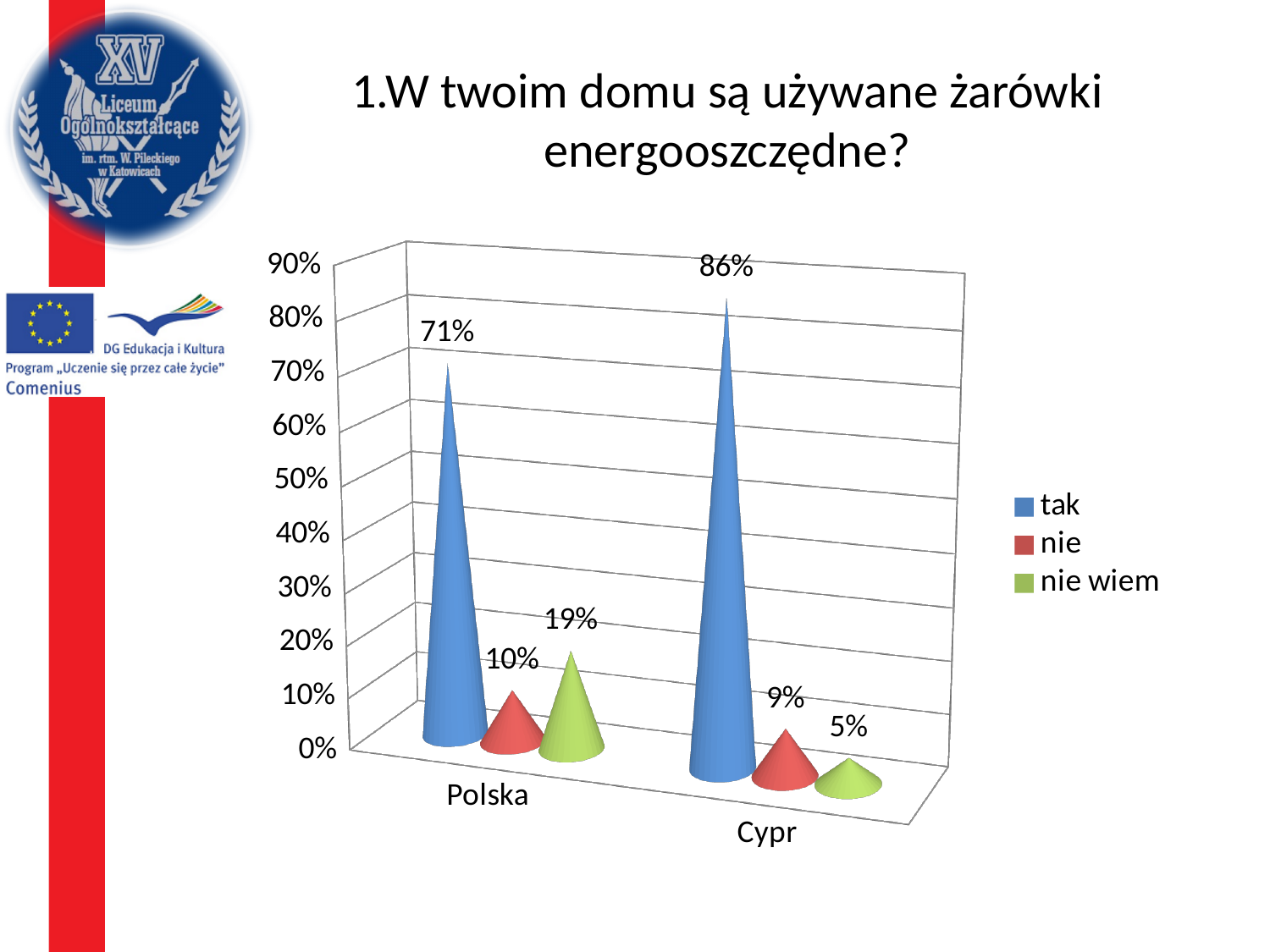
What is the value for "tak" for Cypr? 86% How many series does the legend list? 3 Which series has the highest value for Polska? tak Which country has the higher value for "tak"? Cypr What is the difference between the "tak" values for Cypr and Polska? 15% What is the value for "nie" for Cypr? 9% How many countries are shown on the x axis? 2 What is the difference between the "nie wiem" values for Polska and Cypr? 14% What is the value for "tak" for Polska? 71% Which series has the lowest value for Cypr? nie wiem What colour represents the "nie" series? Red What is the value for "nie wiem" for Polska? 19%